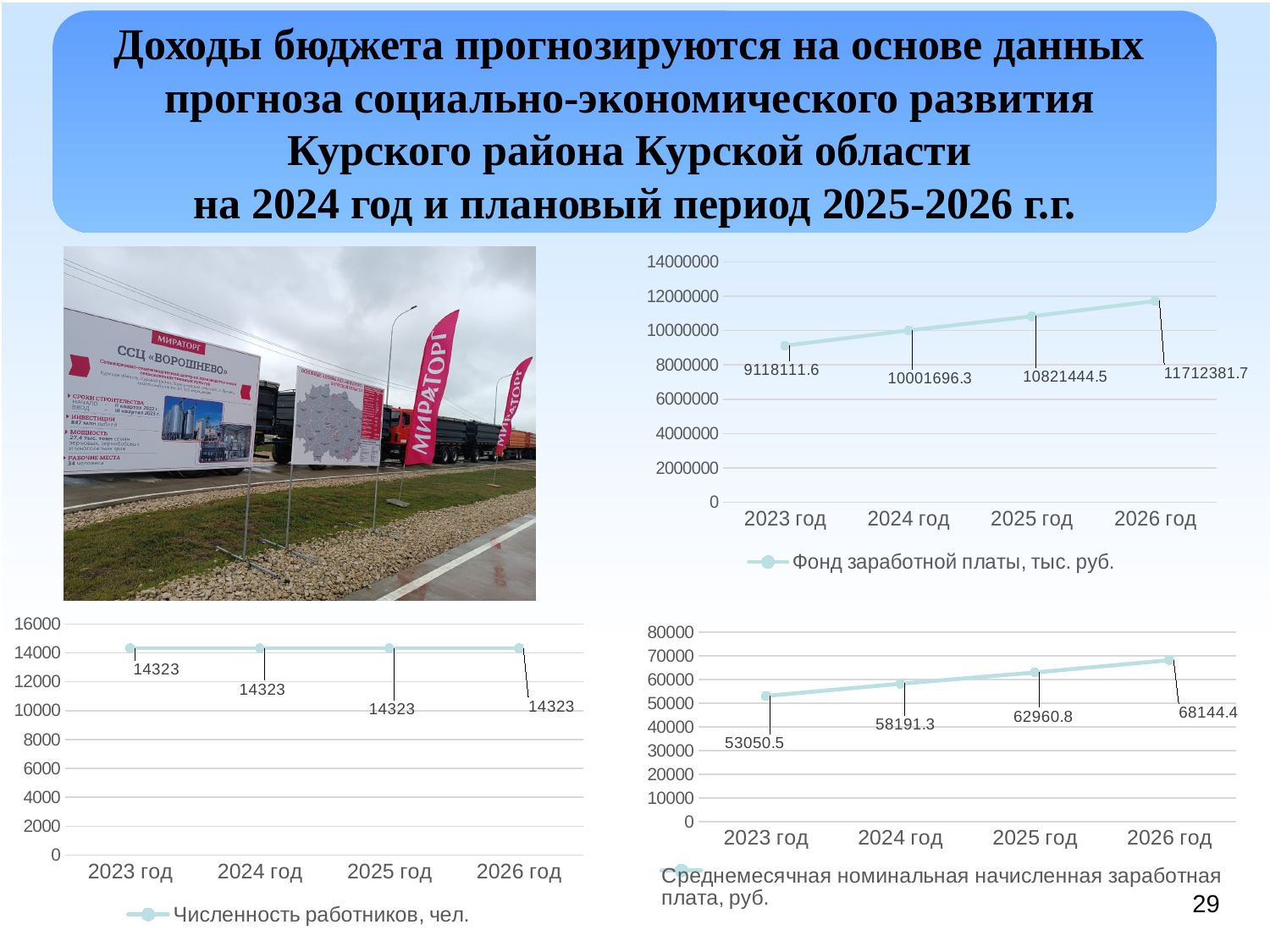
In the top-right chart (Фонд заработной платы, тыс. руб.), which year has the highest value? 2026 год What type of chart is the bottom-right chart (Среднемесячная номинальная начисленная заработная плата, руб.)? line chart In the top-right chart (Фонд заработной платы, тыс. руб.), what is the difference between the values for 2025 год and 2024 год? 819748.2 In the top-right chart (Фонд заработной платы, тыс. руб.), what is the value for 2023 год? 9118111.6 In the bottom-right chart (Среднемесячная номинальная начисленная заработная плата, руб.), what is the value for 2025 год? 62960.8 In the bottom-right chart (Среднемесячная номинальная начисленная заработная плата, руб.), what is the difference between the values for 2026 год and 2023 год? 15093.9 How many data points are plotted in the bottom-left chart (Численность работников, чел.)? 4 In the bottom-right chart (Среднемесячная номинальная начисленная заработная плата, руб.), which year has the lowest value? 2023 год In the top-right chart (Фонд заработной платы, тыс. руб.), what is the value for 2026 год? 11712381.7 In the bottom-left chart (Численность работников, чел.), do the values rise, fall or stay the same across the years? stay the same In the bottom-left chart (Численность работников, чел.), what is the value for 2024 год? 14323 In the top-right chart (Фонд заработной платы, тыс. руб.), do the values rise or fall from 2023 год to 2026 год? rise